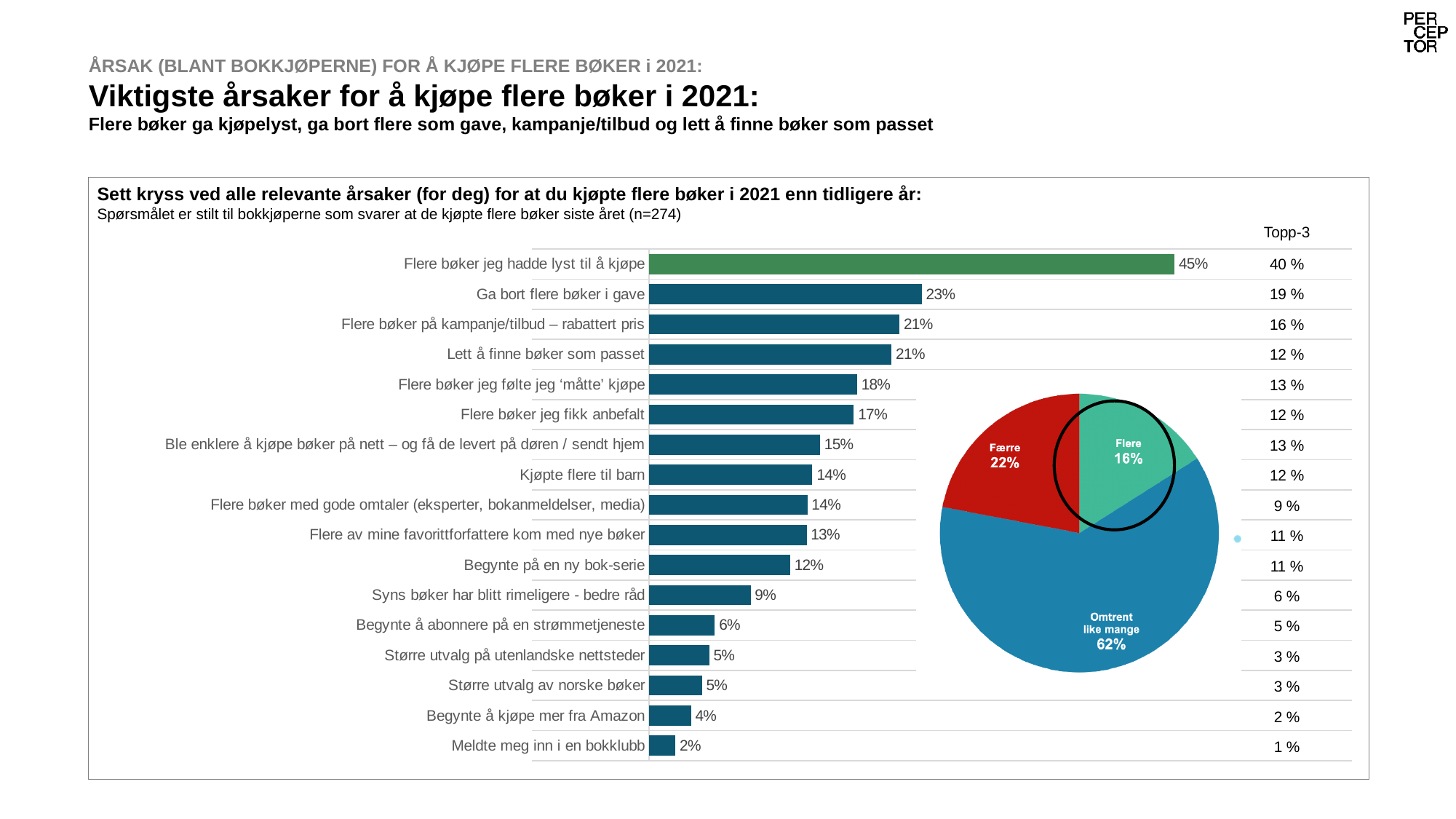
In the pie chart, what share does 'Færre' have? 22% How many categories does the bar chart show? 17 How many slices does the pie chart have? 3 In the bar chart, which category has the lowest value? Meldte meg inn i en bokklubb In the pie chart, which slice is the smallest? Flere In the bar chart, which is larger: 'Kjøpte flere til barn' or 'Begynte på en ny bok-serie'? Kjøpte flere til barn What kind of chart is the chart on the left side of the slide? Bar chart In the pie chart, what share does 'Omtrent like mange' have? 62% In the bar chart, which category has the highest value? Flere bøker jeg hadde lyst til å kjøpe In the bar chart, what is the value for 'Ga bort flere bøker i gave'? 23% In the bar chart, what is the difference between 'Flere bøker jeg hadde lyst til å kjøpe' and 'Ga bort flere bøker i gave'? 22% In the bar chart, what is the value for 'Flere bøker jeg hadde lyst til å kjøpe'? 45%